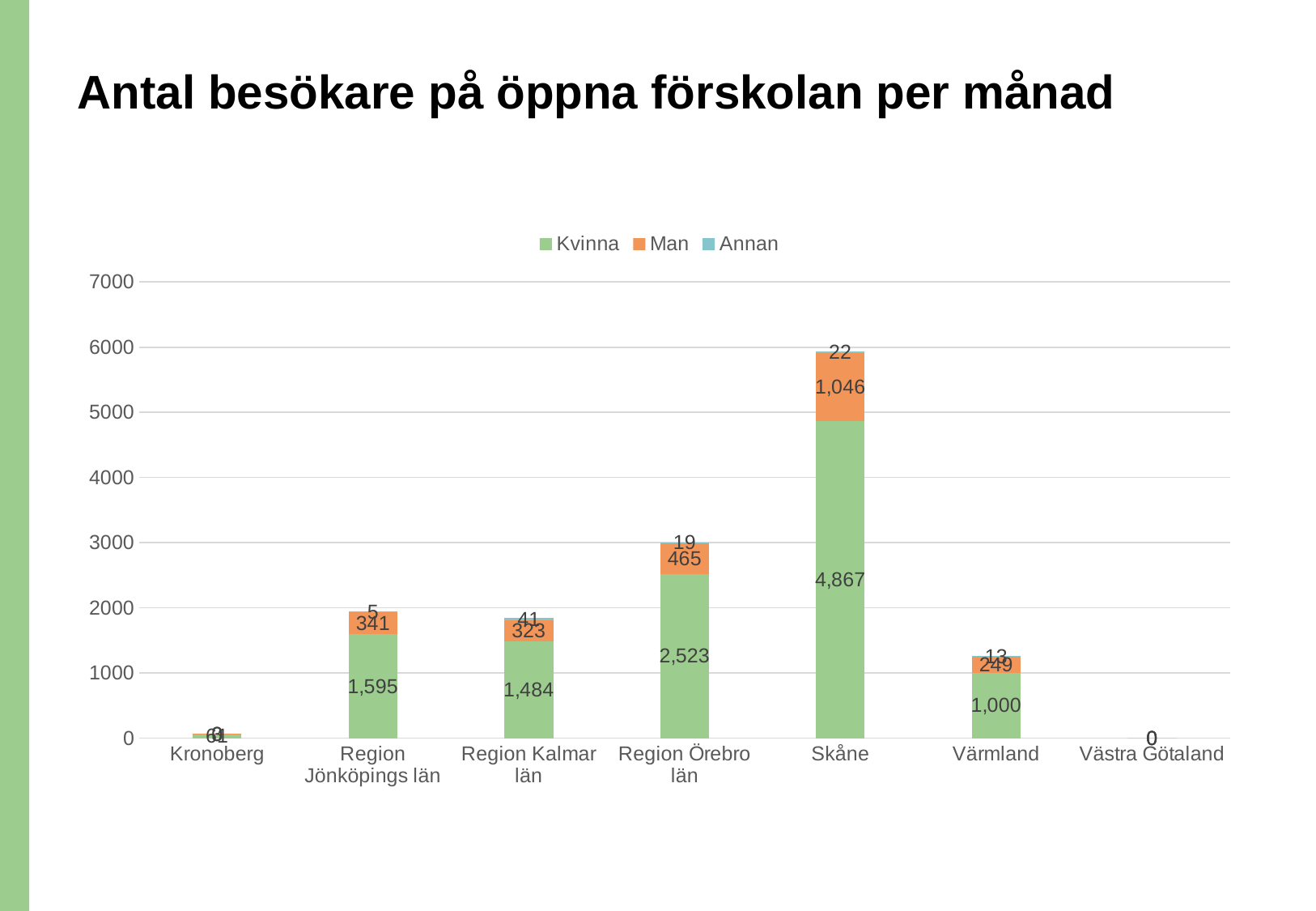
How many regions are shown on the x axis? 7 What kind of chart is shown on the slide? Stacked bar chart What is the Man value for Region Örebro län? 465 What is the Annan value for Skåne? 22 Which region has the highest total number of visitors? Skåne What is the total of the stacked bar for Region Örebro län? 3,007 How many series does the legend list? 3 Which region has the lowest total number of visitors? Västra Götaland What is the difference between the Kvinna values for Skåne and Region Örebro län? 2,344 What is the Kvinna value for Skåne? 4,867 What is the Kvinna value for Region Kalmar län? 1,484 Is the total value for Skåne greater or less than 5000? greater